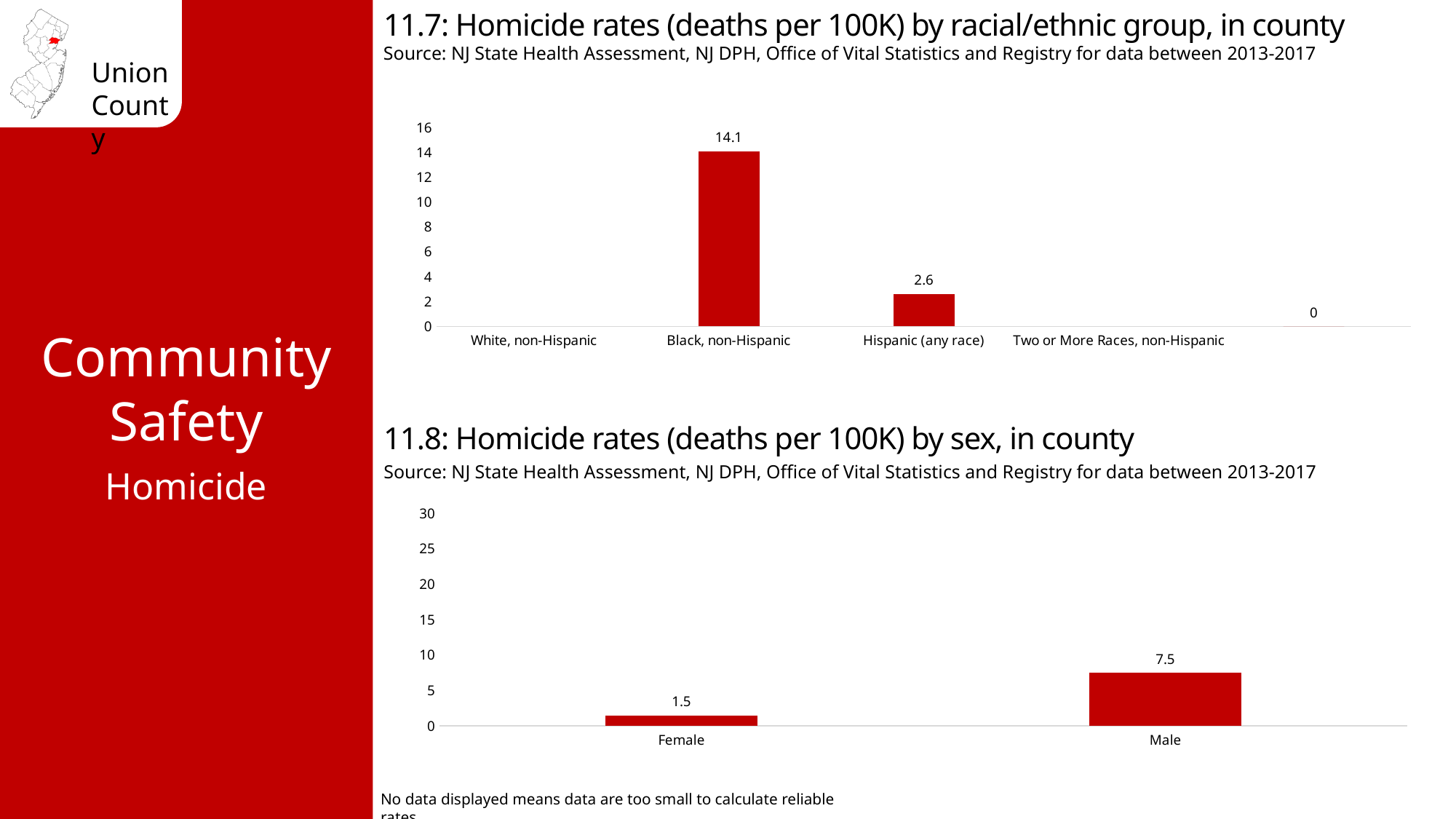
In the chart titled "11.8: Homicide rates (deaths per 100K) by sex, in county", which sex has the higher homicide rate? Male In the chart titled "11.8: Homicide rates (deaths per 100K) by sex, in county", what is the homicide rate for Female? 1.5 In the chart titled "11.7: Homicide rates (deaths per 100K) by racial/ethnic group, in county", what type of chart is used? Bar chart In the chart titled "11.7: Homicide rates (deaths per 100K) by racial/ethnic group, in county", what is the homicide rate for Black, non-Hispanic? 14.1 In the chart titled "11.8: Homicide rates (deaths per 100K) by sex, in county", is the value for Male greater or less than 10? less In the chart titled "11.8: Homicide rates (deaths per 100K) by sex, in county", what is the homicide rate for Male? 7.5 In the chart titled "11.7: Homicide rates (deaths per 100K) by racial/ethnic group, in county", which racial/ethnic group has the highest homicide rate? Black, non-Hispanic In the chart titled "11.7: Homicide rates (deaths per 100K) by racial/ethnic group, in county", how many racial/ethnic group categories are shown on the x axis? 4 In the chart titled "11.7: Homicide rates (deaths per 100K) by racial/ethnic group, in county", what is the homicide rate for Hispanic (any race)? 2.6 In the chart titled "11.7: Homicide rates (deaths per 100K) by racial/ethnic group, in county", what is the difference between the rates for Black, non-Hispanic and Hispanic (any race)? 11.5 In the chart titled "11.8: Homicide rates (deaths per 100K) by sex, in county", what is the difference between the Male and Female homicide rates? 6.0